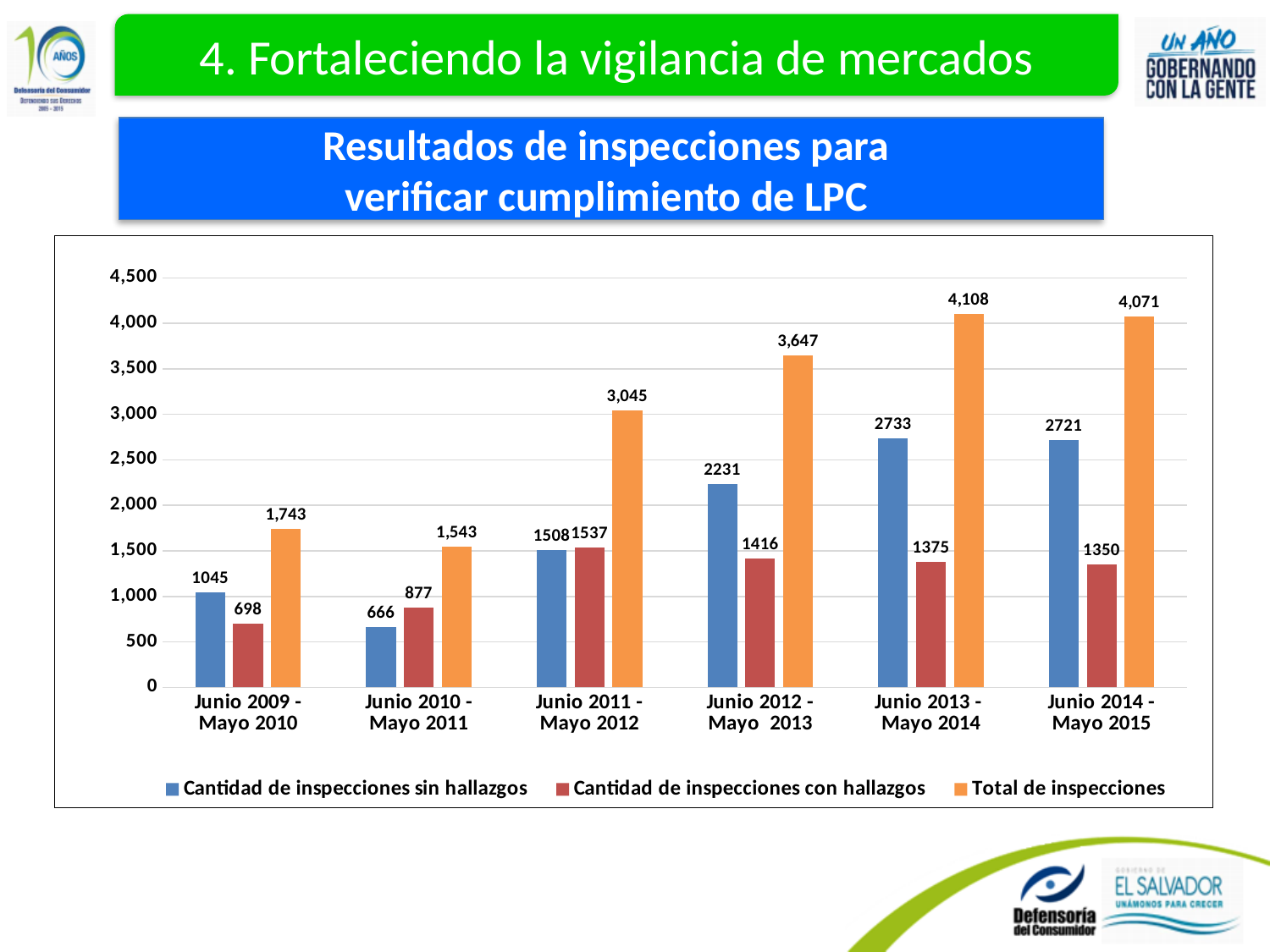
What is the difference between "Cantidad de inspecciones sin hallazgos" and "Cantidad de inspecciones con hallazgos" for Junio 2012 - Mayo 2013? 815 What is the value of "Cantidad de inspecciones sin hallazgos" for Junio 2012 - Mayo 2013? 2231 Which period has the lowest value for "Cantidad de inspecciones sin hallazgos"? Junio 2010 - Mayo 2011 What kind of chart is shown on the slide? Bar chart Does "Total de inspecciones" rise or fall from Junio 2010 - Mayo 2011 to Junio 2013 - Mayo 2014? Rise How many periods are shown on the x axis? 6 For Junio 2011 - Mayo 2012, which is larger: "Cantidad de inspecciones sin hallazgos" or "Cantidad de inspecciones con hallazgos"? Cantidad de inspecciones con hallazgos What is the difference between "Total de inspecciones" for Junio 2013 - Mayo 2014 and Junio 2014 - Mayo 2015? 37 What is the value of "Cantidad de inspecciones con hallazgos" for Junio 2010 - Mayo 2011? 877 How many series does the legend list? 3 What is the value of "Total de inspecciones" for Junio 2013 - Mayo 2014? 4,108 Which period has the highest value for "Total de inspecciones"? Junio 2013 - Mayo 2014